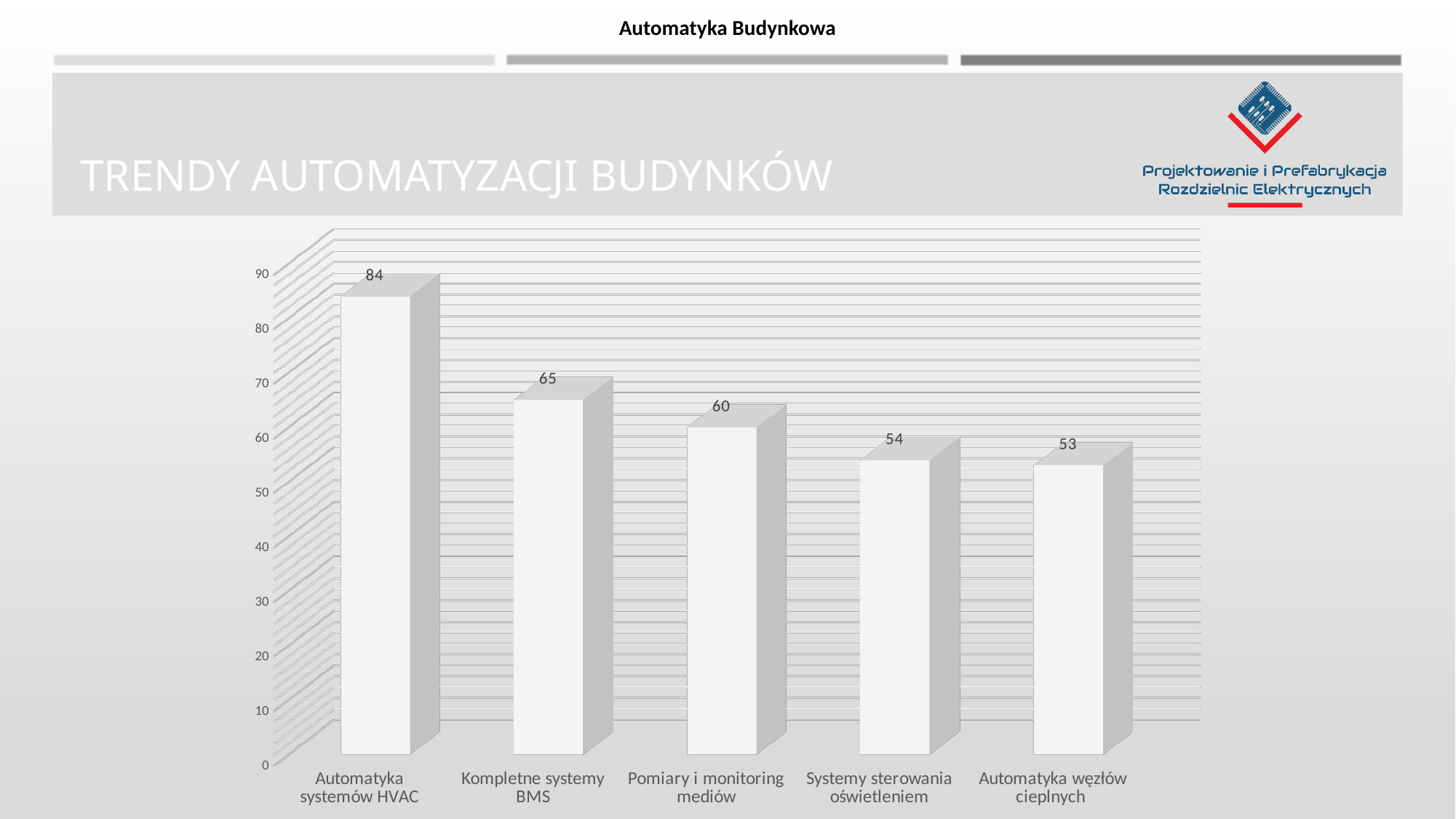
Which category has the highest value? Automatyka systemów HVAC What is the value for Pomiary i monitoring mediów? 60 What is the difference between the values for Automatyka systemów HVAC and Kompletne systemy BMS? 19 Which category has the lowest value? Automatyka węzłów cieplnych What is the value for Automatyka węzłów cieplnych? 53 What is the value for Systemy sterowania oświetleniem? 54 Which is larger, the value for Kompletne systemy BMS or the value for Pomiary i monitoring mediów? Kompletne systemy BMS Do the values rise or fall from left to right along the x axis? Fall How many categories are shown in the chart? 5 What is the value for Automatyka systemów HVAC? 84 What is the value for Kompletne systemy BMS? 65 What kind of chart is shown on the slide? Bar chart